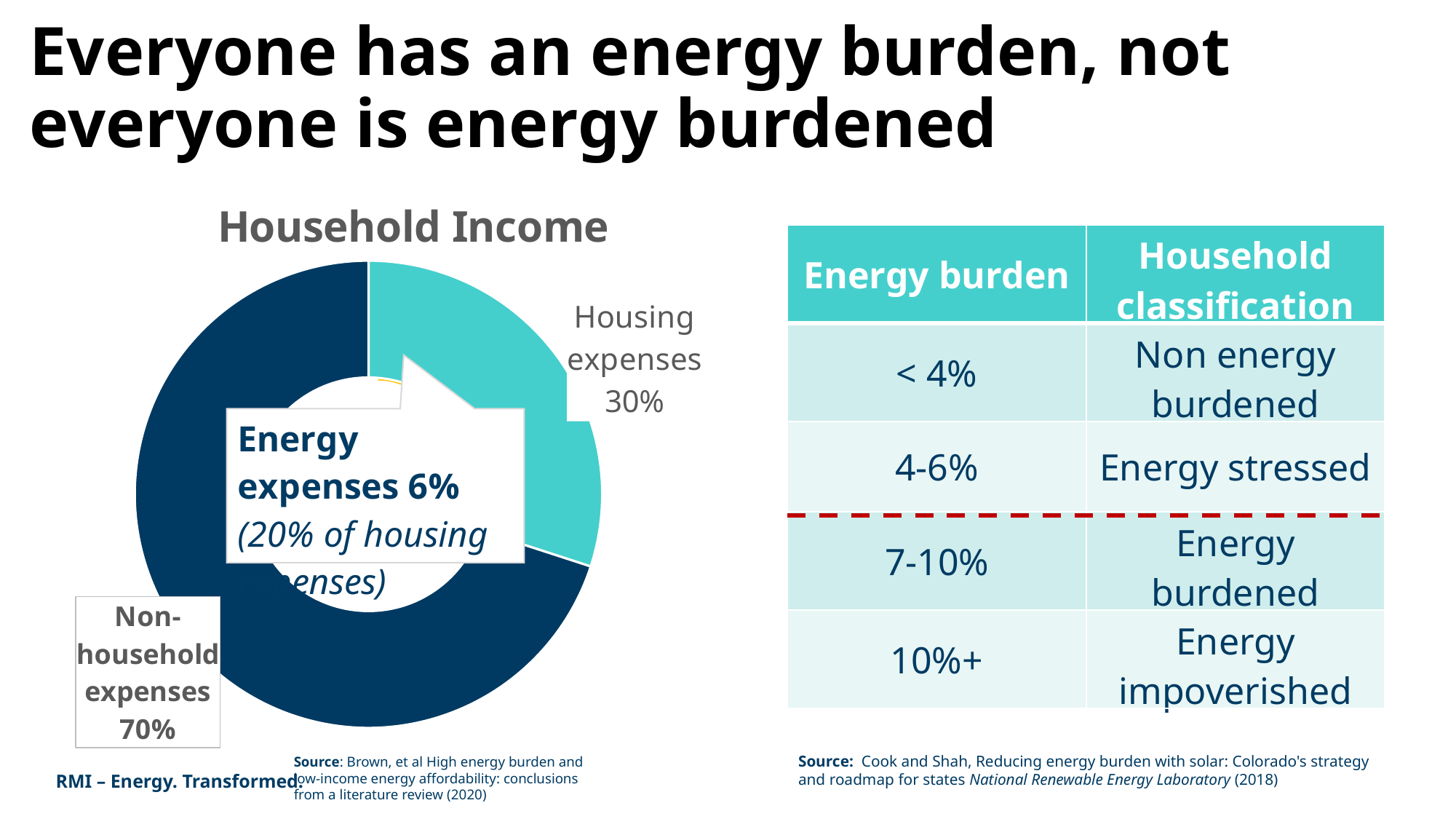
In the Household Income chart, what is the combined share of housing expenses and non-household expenses? 100% In the Household Income chart, what is the difference in percentage points between non-household expenses and housing expenses? 40 In the Household Income chart, what share of household income goes to housing expenses? 30% What kind of chart is the Household Income chart? doughnut chart In the Household Income chart, what colour is the non-household expenses slice? dark blue What is the title of the chart on the left of the slide? Household Income In the Household Income chart, what share of household income goes to non-household expenses? 70% In the Household Income chart, which slice is the largest? Non-household expenses In the Household Income chart, what share of household income goes to energy expenses? 6% According to the Household Income chart, energy expenses are what percentage of housing expenses? 20% In the Household Income chart, which is larger: housing expenses or non-household expenses? Non-household expenses